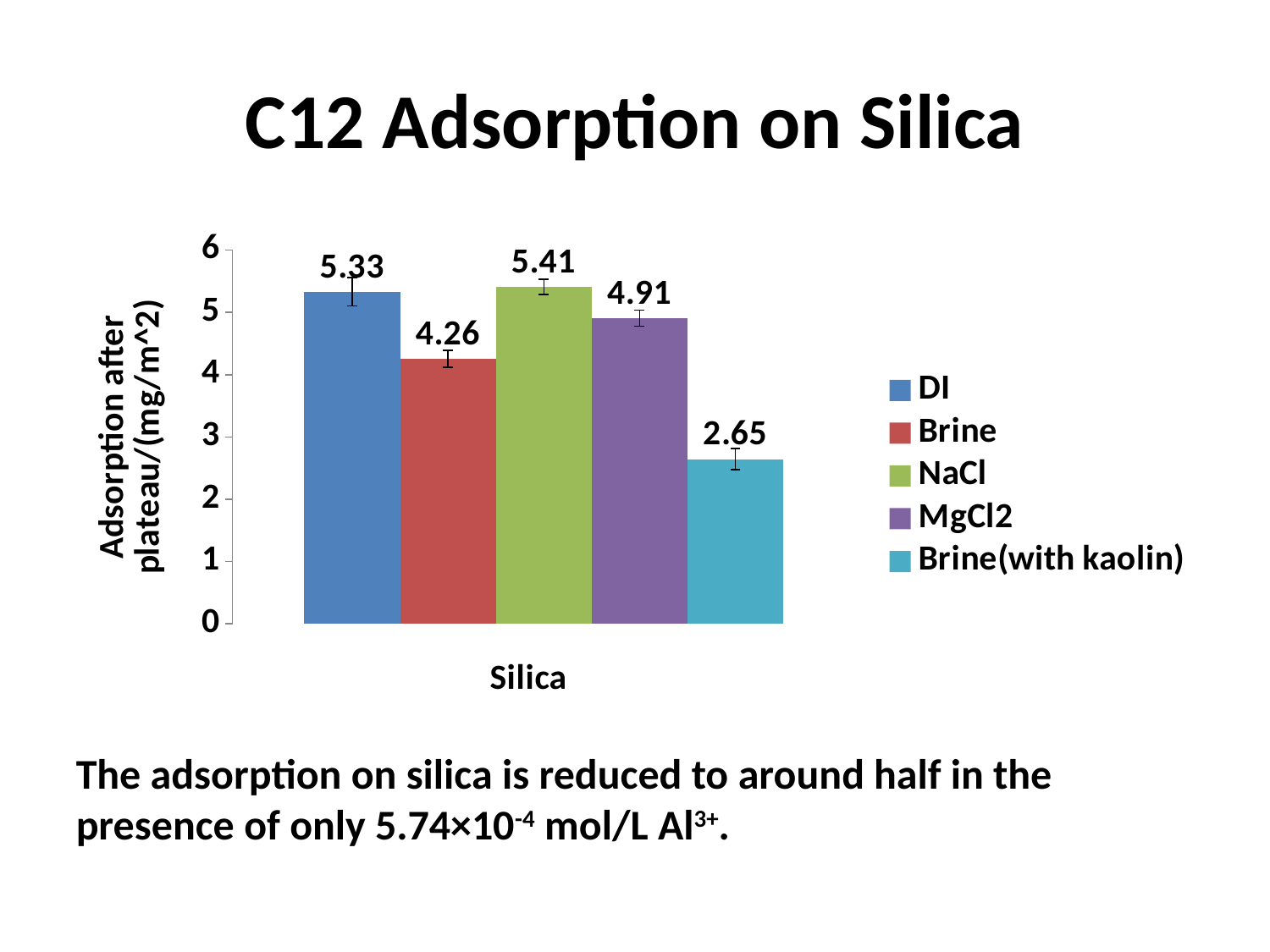
Which series has the lowest adsorption value? Brine(with kaolin) How many series does the legend list? 5 What is the adsorption value for MgCl2? 4.91 What is the difference between the adsorption values for DI and Brine(with kaolin)? 2.68 What is the adsorption value for Brine? 4.26 What is the adsorption value for NaCl? 5.41 What is the adsorption value for Brine(with kaolin)? 2.65 What is the title of the chart on the slide? C12 Adsorption on Silica What is the difference between the adsorption values for MgCl2 and Brine? 0.65 Which has a larger adsorption value, Brine or MgCl2? MgCl2 What is the adsorption value for DI? 5.33 What kind of chart is shown on the slide? Bar chart